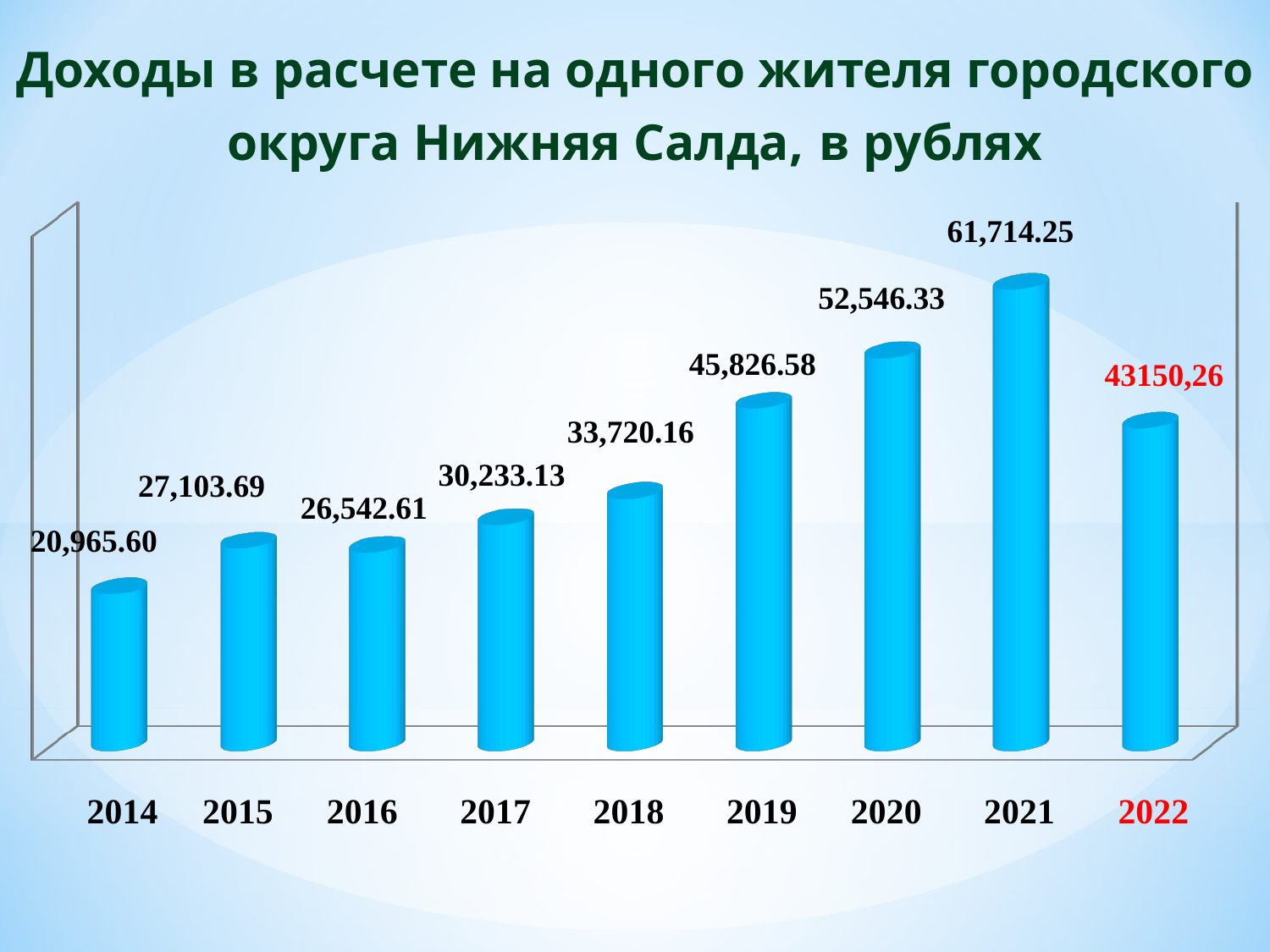
What is the value for 2018? 33,720.16 Do the values rise or fall from 2017 to 2021? Rise What is the value for 2014? 20,965.60 What is the difference between the values for 2019 and 2018? 12,106.42 What is the difference between the values for 2021 and 2020? 9,167.92 Which year has the highest value? 2021 What is the value for 2021? 61,714.25 How many years are shown on the chart? 9 Which year has the lowest value? 2014 What kind of chart is shown on the slide? Bar chart Which is larger, the value for 2015 or the value for 2016? 2015 What is the value for 2022? 43150,26